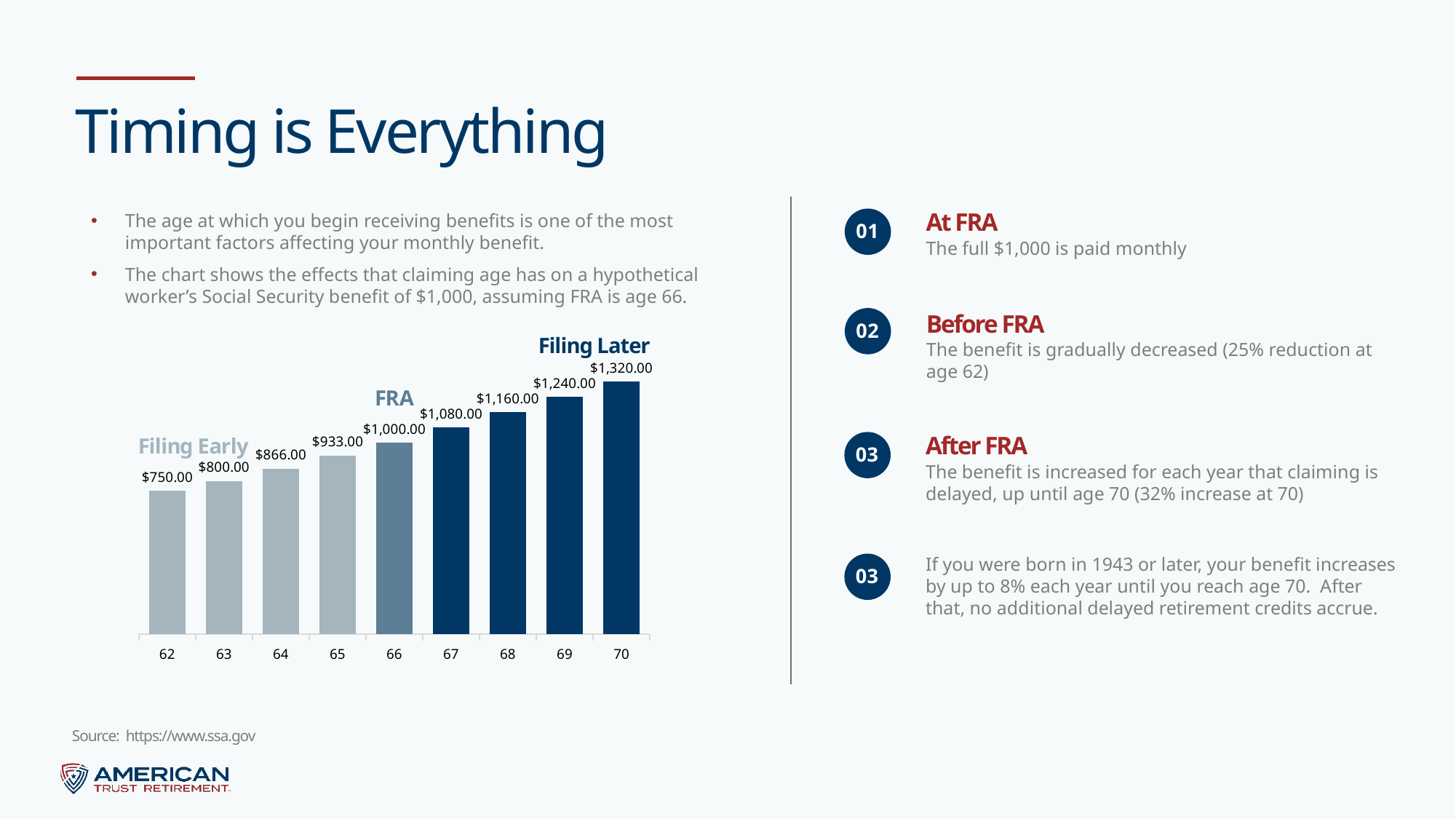
Which is larger, the benefit at age 65 or the benefit at age 69? 69 What is the monthly benefit shown for claiming at age 64? $866.00 Which claiming age has the lowest monthly benefit? 62 What is the monthly benefit shown for claiming at age 66? $1,000.00 What kind of chart is shown on the slide? Bar chart What is the monthly benefit shown for claiming at age 62? $750.00 Do the benefit values rise or fall as the claiming age increases? Rise How many claiming ages are shown on the chart? 9 What is the difference between the benefit at age 67 and the benefit at age 66? $80.00 What is the monthly benefit shown for claiming at age 68? $1,160.00 Which claiming age has the highest monthly benefit? 70 What is the difference between the benefit at age 70 and the benefit at age 62? $570.00